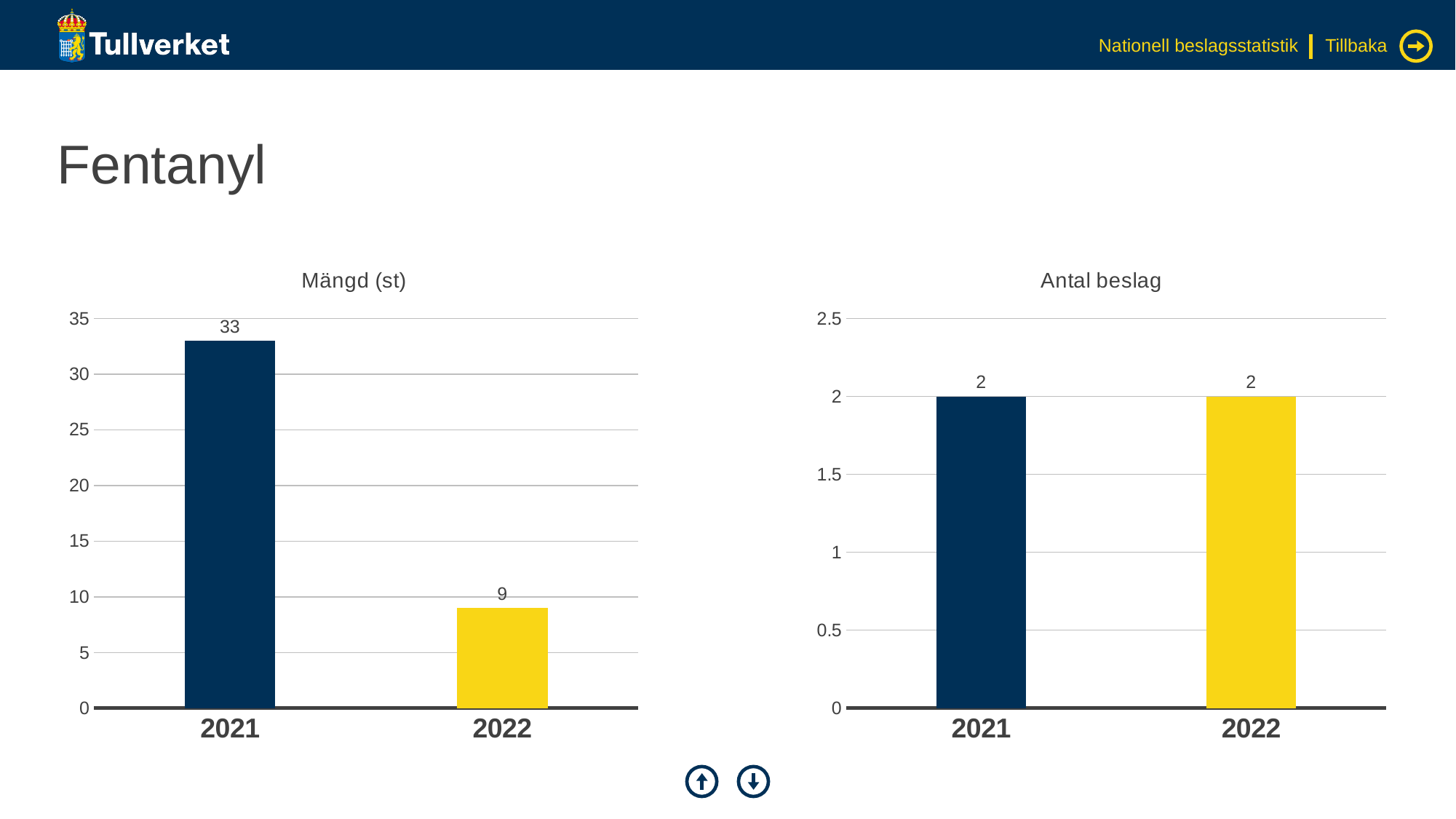
In the 'Mängd (st)' chart, do the values rise or fall from 2021 to 2022? fall What is the title of the chart on the right side of the slide? Antal beslag In the 'Mängd (st)' chart, what is the value for 2022? 9 In the 'Mängd (st)' chart, is the value for 2021 greater or less than 30? greater In the 'Antal beslag' chart, what is the value for 2021? 2 In the 'Mängd (st)' chart, which year has the highest value? 2021 In the 'Antal beslag' chart, what is the value for 2022? 2 In the 'Mängd (st)' chart, what is the difference between the values for 2021 and 2022? 24 In the 'Mängd (st)' chart, what is the value for 2021? 33 In the 'Mängd (st)' chart, which year has the lowest value? 2022 What kind of chart is the 'Antal beslag' chart? bar chart In the 'Mängd (st)' chart, how many years are shown on the x axis? 2